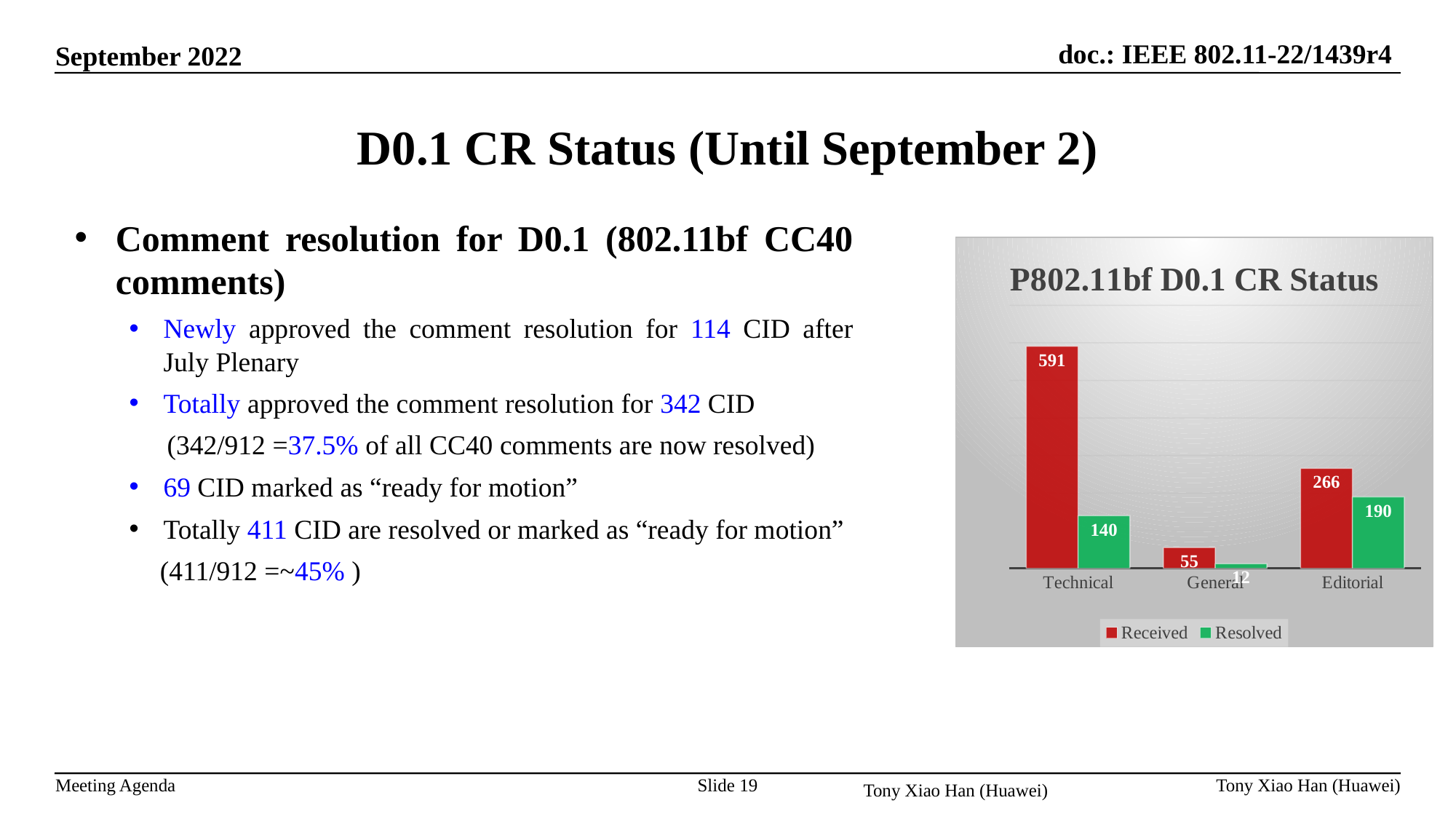
Which category has the lowest Resolved value? General What is the Resolved value for Editorial? 190 What kind of chart is shown? Bar chart What is the difference between Received and Resolved for Technical? 451 Which is larger, the Received value for Editorial or the Resolved value for Technical? Received value for Editorial What is the Received value for General? 55 What is the difference between Received and Resolved for Editorial? 76 How many series does the legend list? 2 What is the Received value for Technical? 591 How many categories are shown on the x axis? 3 What is the Resolved value for Technical? 140 Which category has the highest Received value? Technical